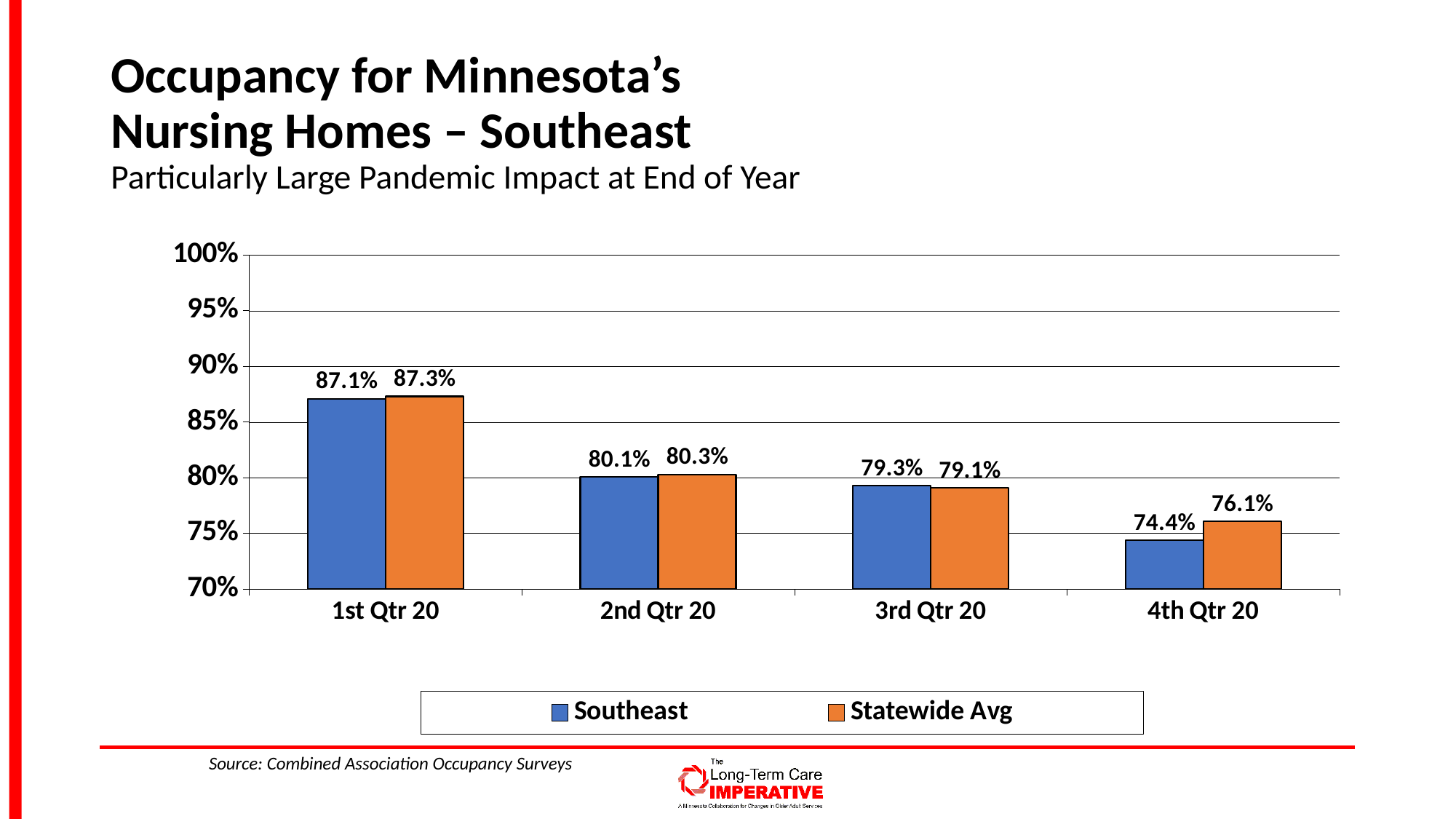
What is the Southeast occupancy value for 1st Qtr 20? 87.1% Is the Southeast value for 4th Qtr 20 greater or less than 75%? less What is the Southeast occupancy value for 3rd Qtr 20? 79.3% Does the Southeast occupancy rise or fall from 1st Qtr 20 to 4th Qtr 20? fall In 3rd Qtr 20, which is larger: the Southeast value or the Statewide Avg value? Southeast What is the difference between the Statewide Avg and Southeast values in 4th Qtr 20? 1.7% What is the Statewide Avg occupancy value for 4th Qtr 20? 76.1% Which quarter has the lowest Southeast occupancy? 4th Qtr 20 How many series does the legend list? 2 Which quarter has the highest Statewide Avg occupancy? 1st Qtr 20 How many quarters are shown on the x axis? 4 What is the difference between the Southeast values for 1st Qtr 20 and 2nd Qtr 20? 7.0%